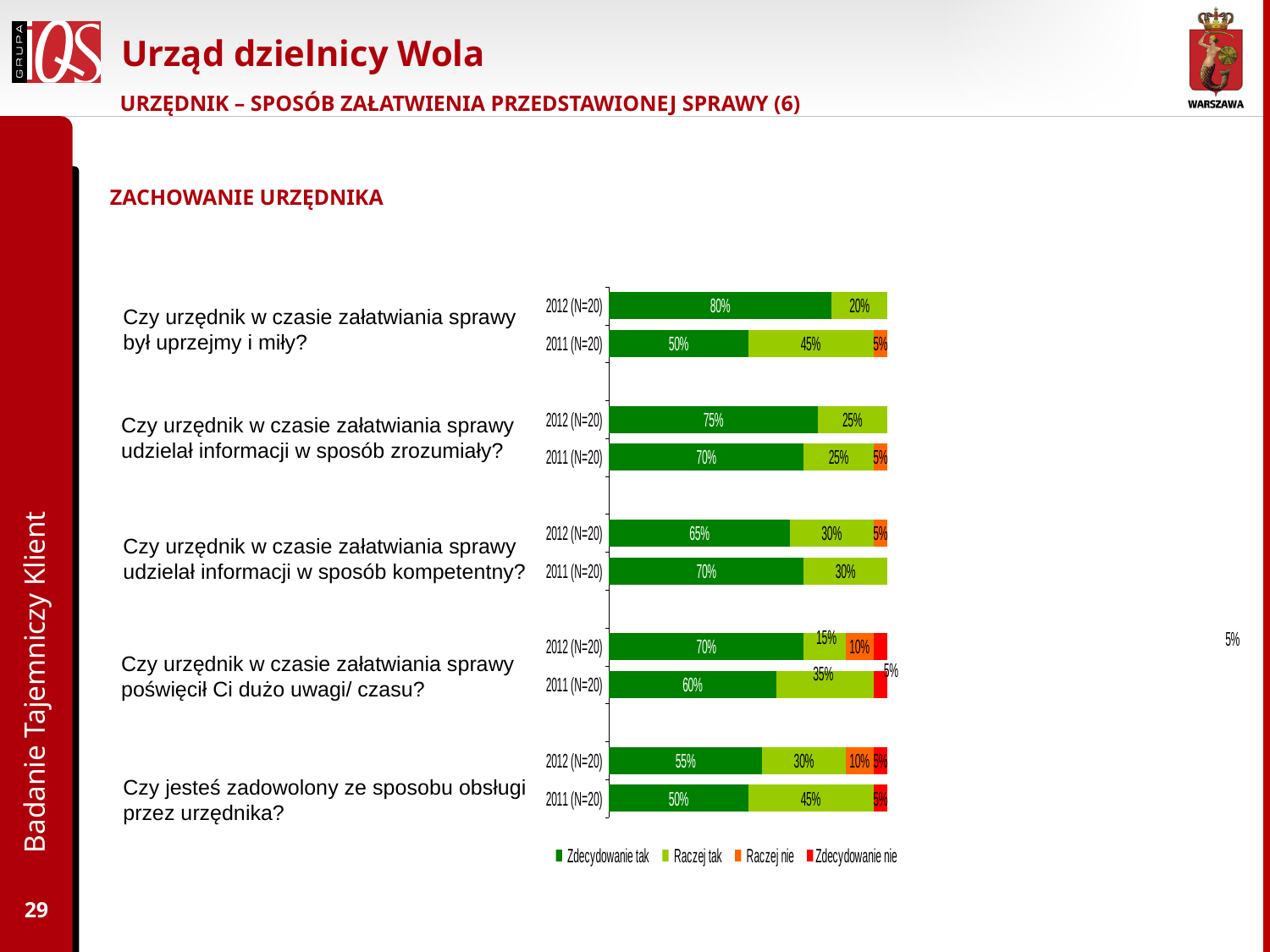
What is the difference between the 'Zdecydowanie tak' values for 2012 and 2011 for the question 'Czy urzędnik w czasie załatwiania sprawy był uprzejmy i miły?' 30% For the question 'Czy urzędnik w czasie załatwiania sprawy udzielał informacji w sposób kompetentny?', which year has the larger 'Zdecydowanie tak' value, 2012 or 2011? 2011 What is the 'Zdecydowanie tak' value for 2012 (N=20) for the question 'Czy urzędnik w czasie załatwiania sprawy był uprzejmy i miły?' 80% What is the first entry in the chart legend? Zdecydowanie tak What is the 'Raczej tak' value for 2011 (N=20) for the question 'Czy urzędnik w czasie załatwiania sprawy poświęcił Ci dużo uwagi/ czasu?' 35% How many series does the legend list? 4 What is the 'Zdecydowanie tak' value for 2012 (N=20) for the question 'Czy urzędnik w czasie załatwiania sprawy udzielał informacji w sposób zrozumiały?' 75% Which bar has the highest 'Zdecydowanie tak' value? 2012 (N=20) for 'Czy urzędnik w czasie załatwiania sprawy był uprzejmy i miły?' How many survey questions are shown in the chart? 5 What kind of chart is shown on the slide? bar chart What is the 'Raczej tak' value for 2011 (N=20) for the question 'Czy urzędnik w czasie załatwiania sprawy był uprzejmy i miły?' 45% What is the 'Zdecydowanie tak' value for 2012 (N=20) for the question 'Czy jesteś zadowolony ze sposobu obsługi przez urzędnika?' 55%